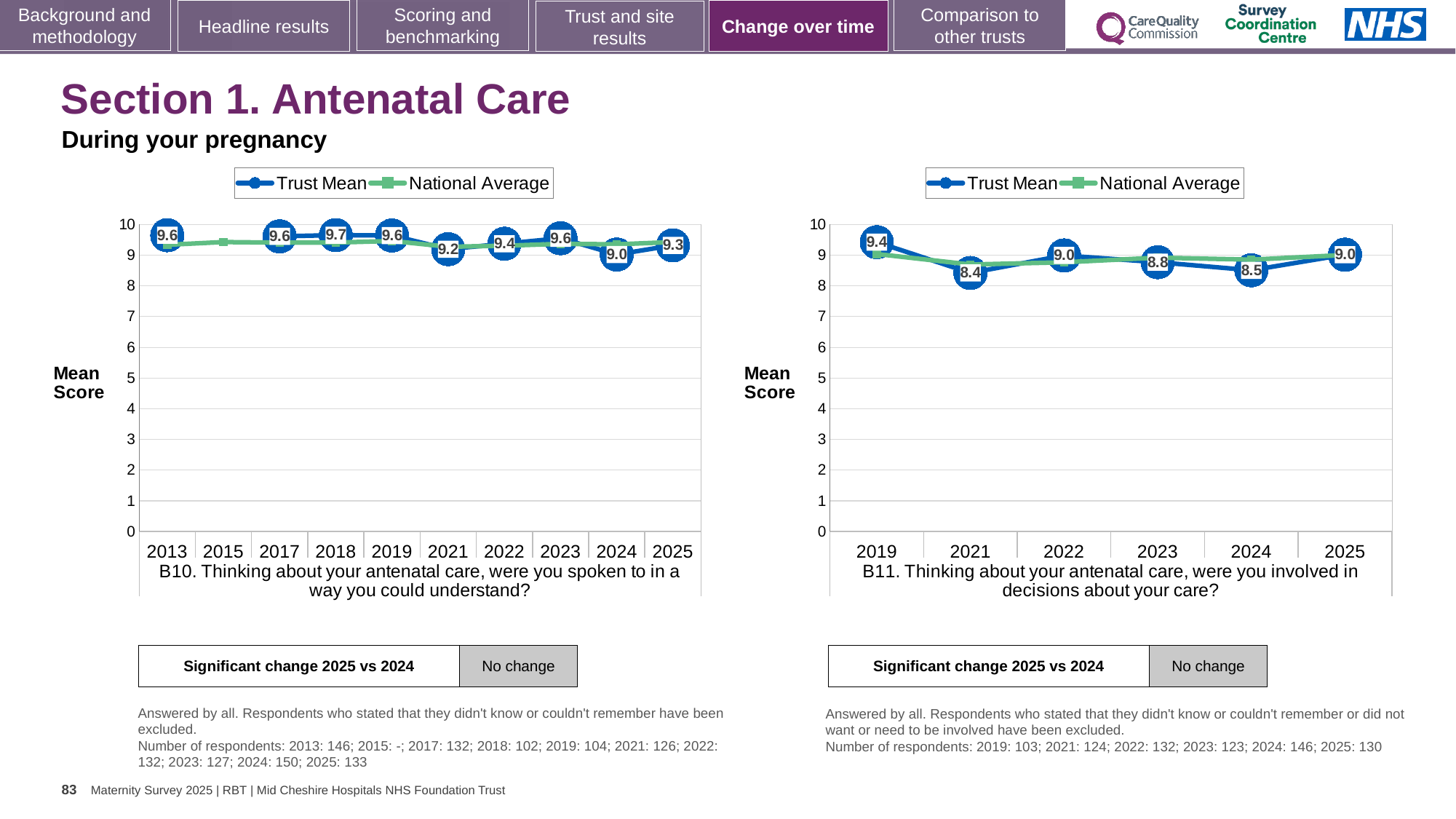
On the B11 chart (right), what is the Trust Mean for 2021? 8.4 On the B10 chart (left), what is the difference between the Trust Mean in 2025 and in 2024? 0.3 On the B10 chart (left), which year has the lowest Trust Mean? 2024 On the B11 chart (right), which year has the lowest Trust Mean? 2021 On the B10 chart (left), how many years are shown on the x axis? 10 On the B10 chart (left), what is the Trust Mean for 2018? 9.7 On the B10 chart (left), what is the Trust Mean for 2024? 9.0 On the B11 chart (right), which year has the highest Trust Mean? 2019 What kind of chart is the B10 chart on the left? Line chart On the B10 chart (left), which year has the highest Trust Mean? 2018 On the B11 chart (right), is the Trust Mean for 2019 or for 2024 larger? 2019 On the B11 chart (right), how many series does the legend list? 2